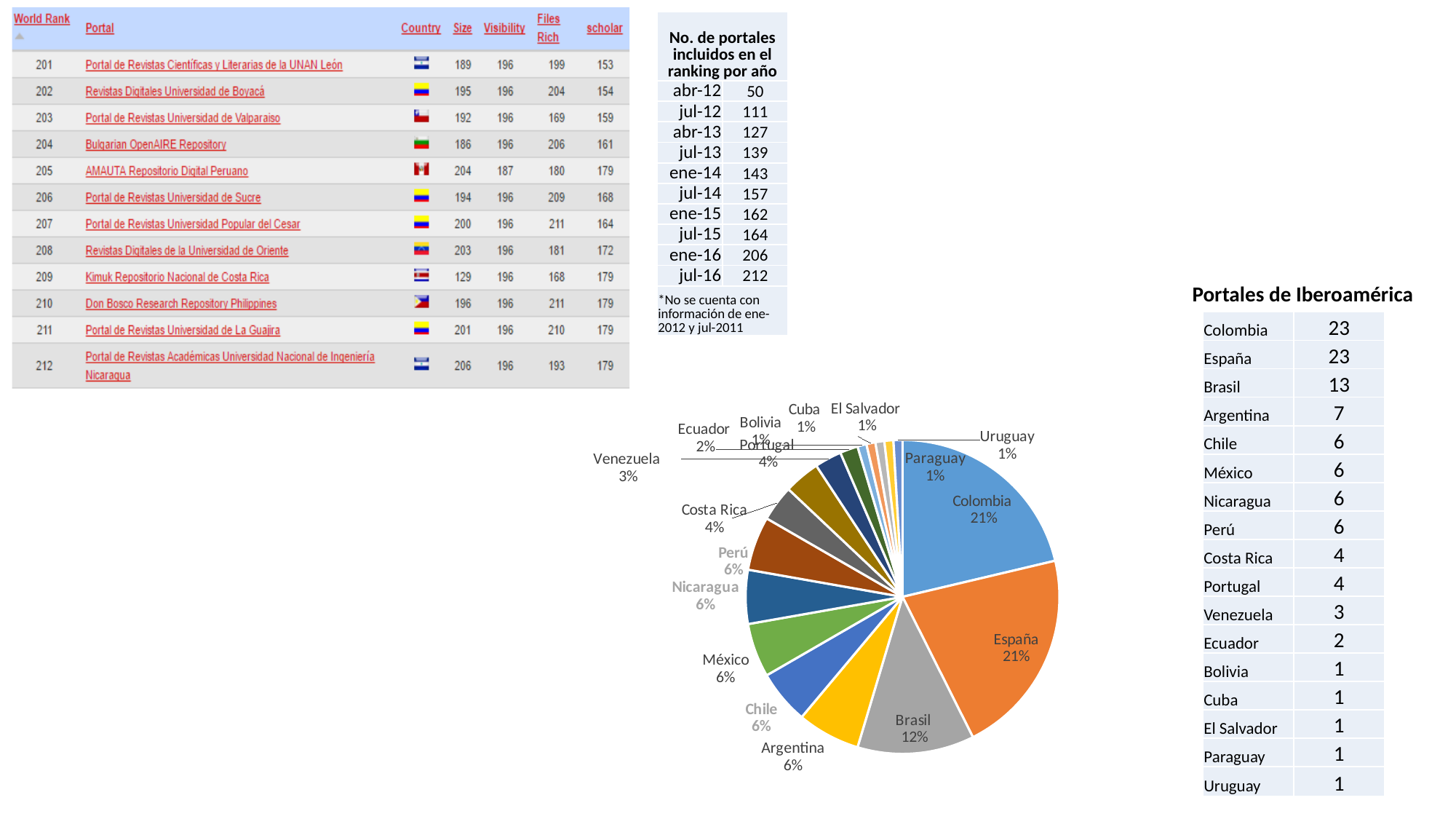
In the pie chart, what share does Cuba have? 1% In the pie chart, which slice is larger, Portugal or Venezuela? Portugal In the pie chart, which slice is larger, Brasil or Argentina? Brasil In the pie chart, what share does Venezuela have? 3% In the pie chart, what share does Colombia have? 21% In the pie chart, what is the difference in percentage points between Colombia and Brasil? 9% How many slices does the pie chart have? 17 In the pie chart, what is the difference in percentage points between Brasil and Costa Rica? 8% What kind of chart is shown on the slide? pie chart